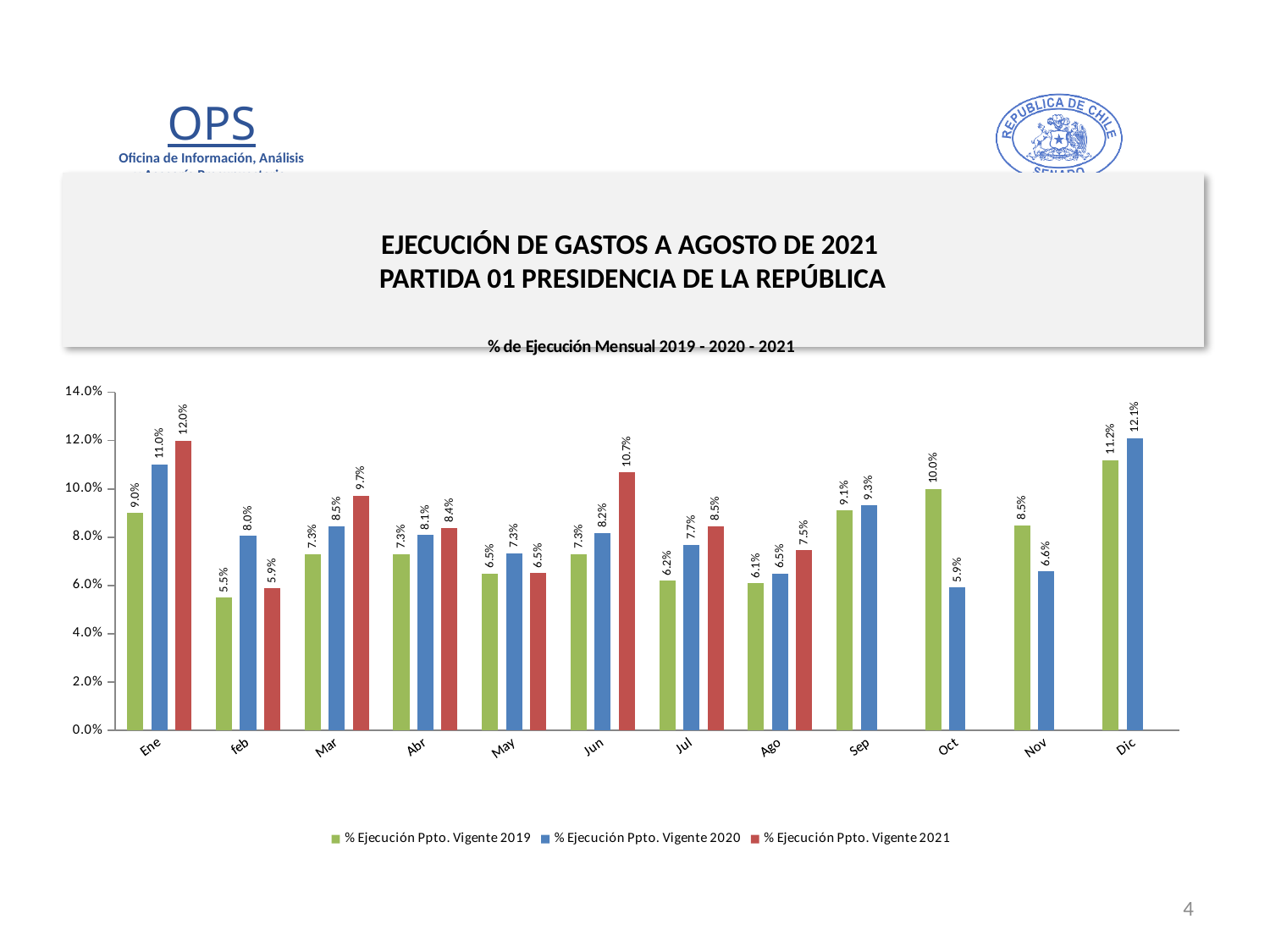
What is the value for % Ejecución Ppto. Vigente 2021 in Jun? 10.7% What is the value for % Ejecución Ppto. Vigente 2019 in Oct? 10.0% How many months are shown on the x axis? 12 Which month has the highest value for % Ejecución Ppto. Vigente 2021? Ene How many series does the legend list? 3 What is the difference between the 2021 and 2019 values in Jun? 3.4 percentage points What kind of chart is shown on the slide? Bar chart What is the title of the chart? % de Ejecución Mensual 2019 - 2020 - 2021 Which month has the lowest value for % Ejecución Ppto. Vigente 2019? feb Which is larger in Oct: the 2019 value or the 2020 value? 2019 (10.0%) What is the value for % Ejecución Ppto. Vigente 2020 in feb? 8.0% Which month has the highest value for % Ejecución Ppto. Vigente 2020? Dic